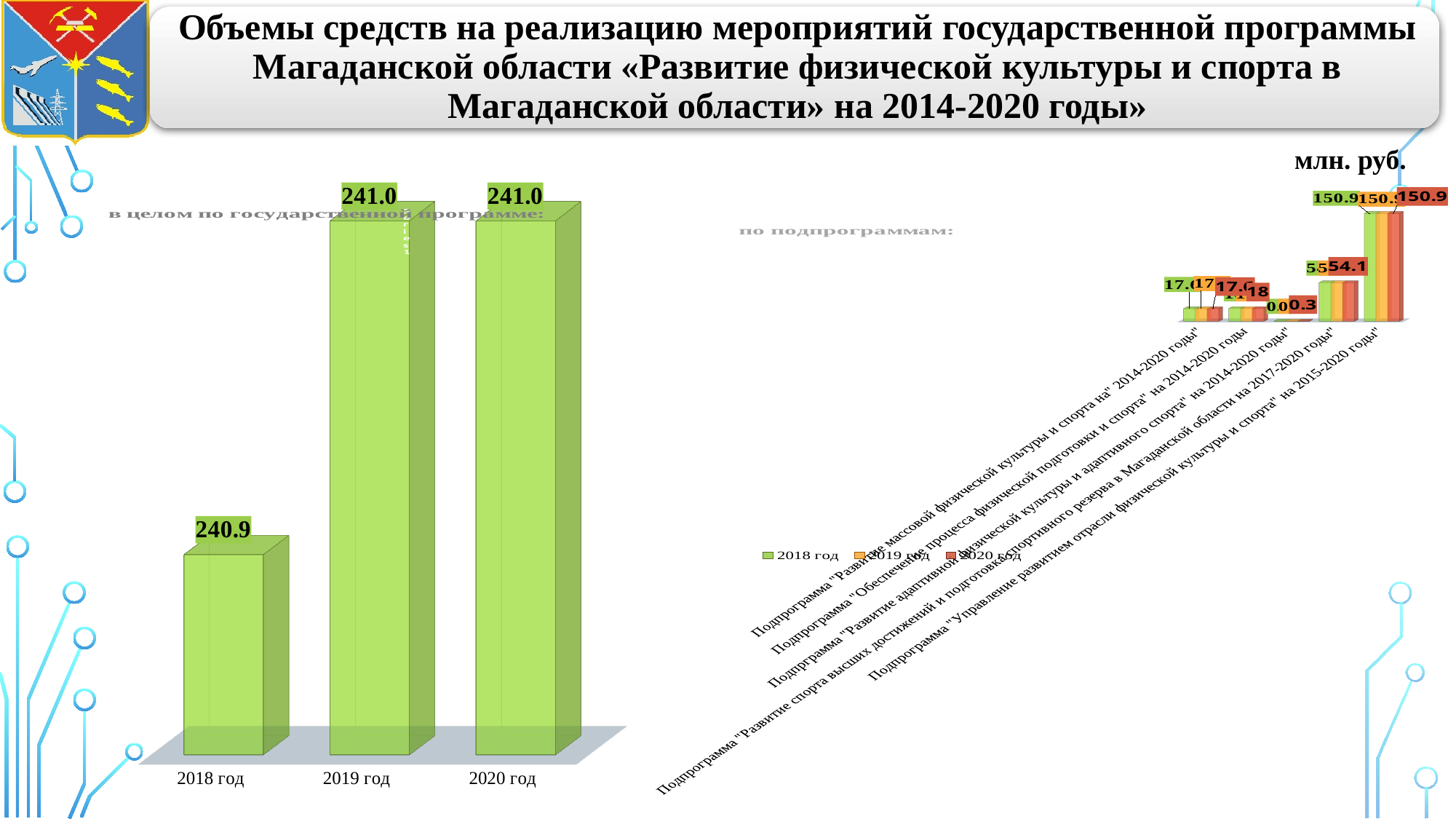
What unit is stated for the values on the slide? млн. руб. In the left chart (в целом по государственной программе), what is the value for 2018 год? 240.9 In the right chart (по подпрограммам), what is the 2020 год value for the subprogram "Управление развитием отрасли физической культуры и спорта"? 150.9 What kind of chart is the left chart (в целом по государственной программе)? Bar chart In the left chart (в целом по государственной программе), what is the value for 2019 год? 241.0 In the left chart (в целом по государственной программе), how many years are shown? 3 How many series does the legend of the right chart (по подпрограммам) list? 3 In the left chart (в целом по государственной программе), which year has the lowest value? 2018 год In the left chart (в целом по государственной программе), what is the value for 2020 год? 241.0 In the right chart (по подпрограммам), what is the 2020 год value for the subprogram "Развитие спорта высших достижений и подготовка спортивного резерва в Магаданской области"? 54.1 In the left chart (в целом по государственной программе), do the values rise or fall from 2018 год to 2019 год? Rise In the left chart (в целом по государственной программе), what is the difference between the values for 2019 год and 2018 год? 0.1